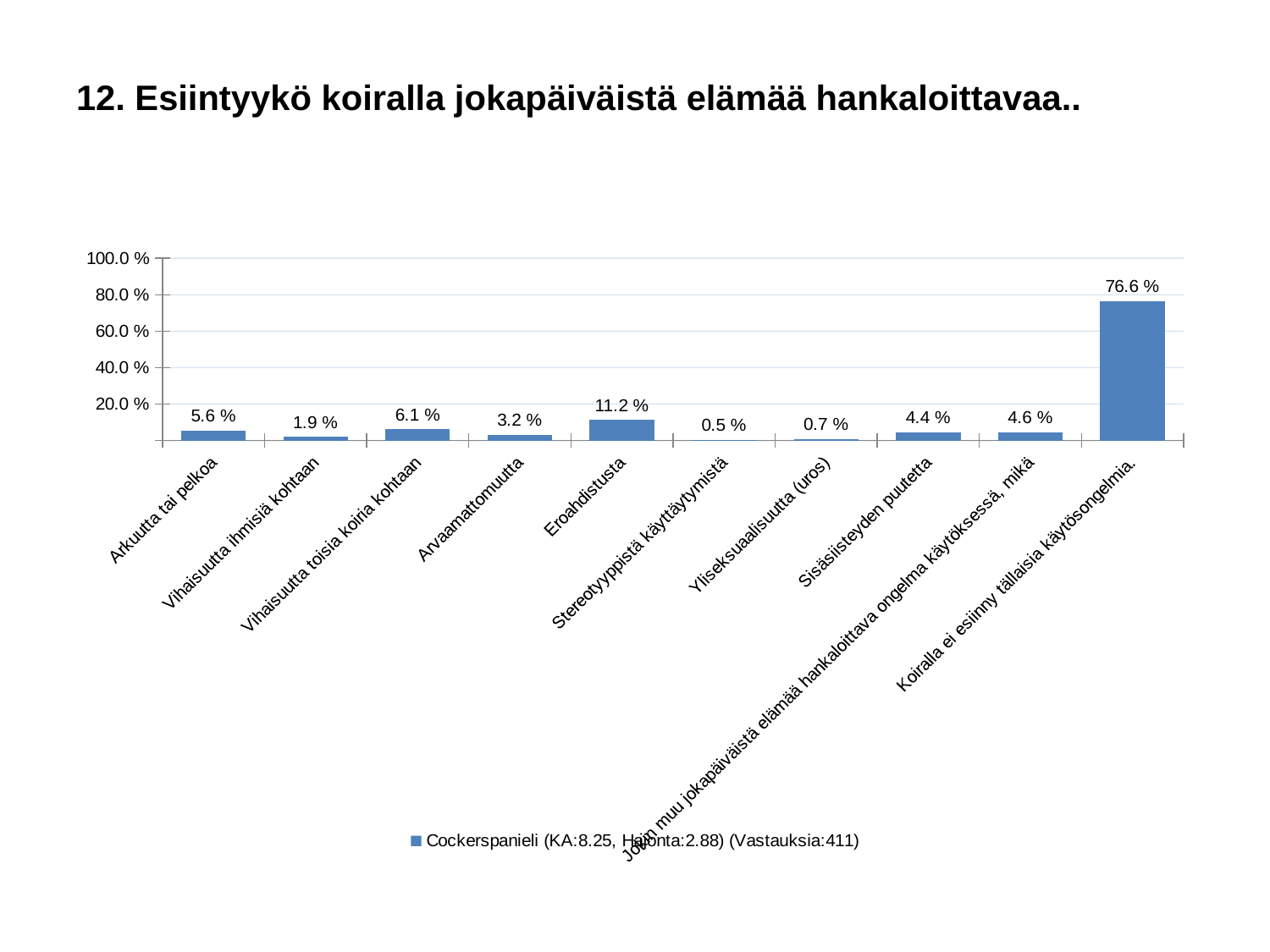
What is the value for "Sisäsiisteyden puutetta"? 4.4 % How many categories are shown on the x axis? 10 Is the value for "Koiralla ei esiinny tällaisia käytösongelmia." greater or less than 60.0 %? greater What is the value for "Koiralla ei esiinny tällaisia käytösongelmia."? 76.6 % What is the difference between the values for "Eroahdistusta" and "Arkuutta tai pelkoa"? 5.6 % What is the value for "Eroahdistusta"? 11.2 % Which category has the lowest value? Stereotyyppistä käyttäytymistä Which category has the highest value? Koiralla ei esiinny tällaisia käytösongelmia. What kind of chart is shown on the slide? bar chart Which is larger, the value for "Vihaisuutta toisia koiria kohtaan" or the value for "Arvaamattomuutta"? Vihaisuutta toisia koiria kohtaan How many responses (Vastauksia) does the legend entry report? 411 What is the value for "Arkuutta tai pelkoa"? 5.6 %